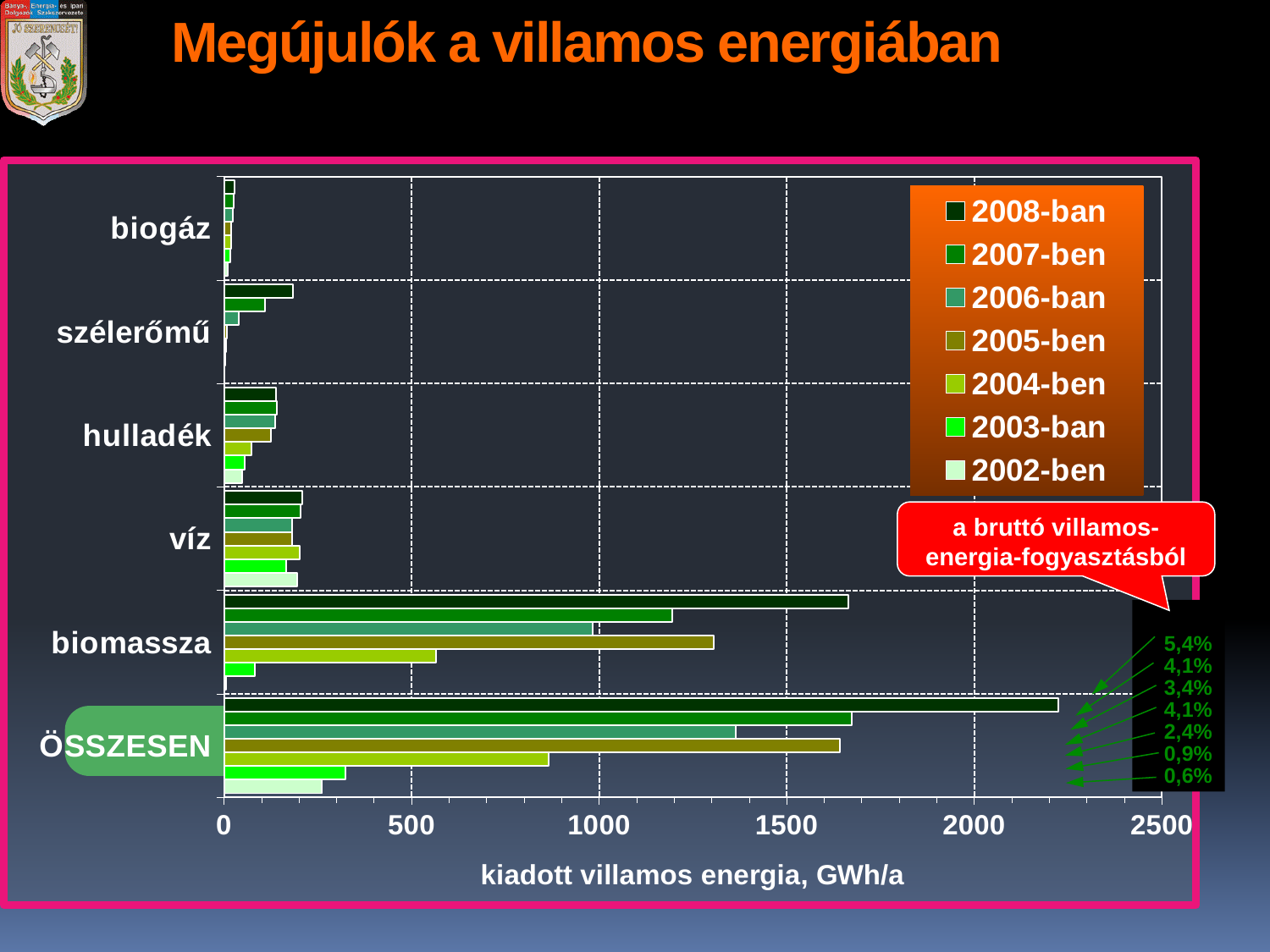
Is the 2008-ban value for ÖSSZESEN greater or less than 2000? greater How many series does the legend list? 7 Is the 2004-ben value for ÖSSZESEN greater or less than 1000? less How many categories are shown on the vertical axis of the chart? 6 What is the title of the horizontal axis of the chart? kiadott villamos energia, GWh/a Is the 2008-ban value for víz greater or less than 500? less Which category has the shortest bar for 2008-ban? biogáz What kind of chart is shown on the slide? bar chart Which category has the longest bar for 2008-ban? ÖSSZESEN For biomassza, which is larger: the 2004-ben value or the 2005-ben value? 2005-ben Do the szélerőmű values rise or fall from 2002-ben to 2008-ban? rise